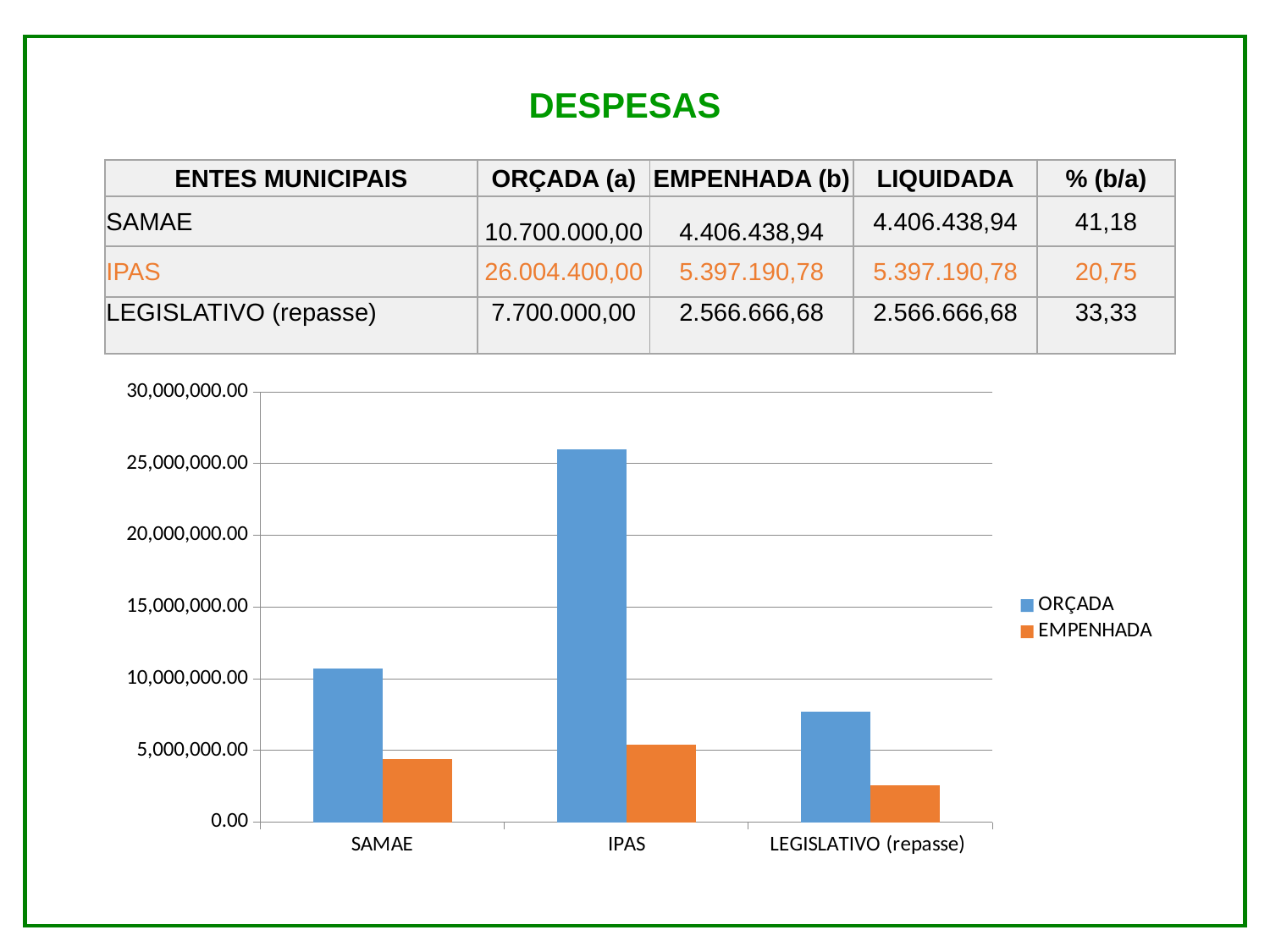
According to the table on the slide, what is the ORÇADA value for IPAS? 26.004.400,00 How many categories are shown on the x axis of the chart? 3 What kind of chart is shown on the slide? bar chart Which category has the lowest ORÇADA bar? LEGISLATIVO (repasse) Which category has the highest EMPENHADA bar? IPAS What colour represents the EMPENHADA series in the chart? orange Is the ORÇADA value for IPAS greater or less than 20,000,000.00? greater Which is larger, the ORÇADA bar for SAMAE or the ORÇADA bar for LEGISLATIVO (repasse)? SAMAE According to the table on the slide, what is the EMPENHADA value for LEGISLATIVO (repasse)? 2.566.666,68 Is the EMPENHADA value for SAMAE greater or less than 5,000,000.00? less How many series does the chart legend list? 2 Which category has the highest ORÇADA bar? IPAS